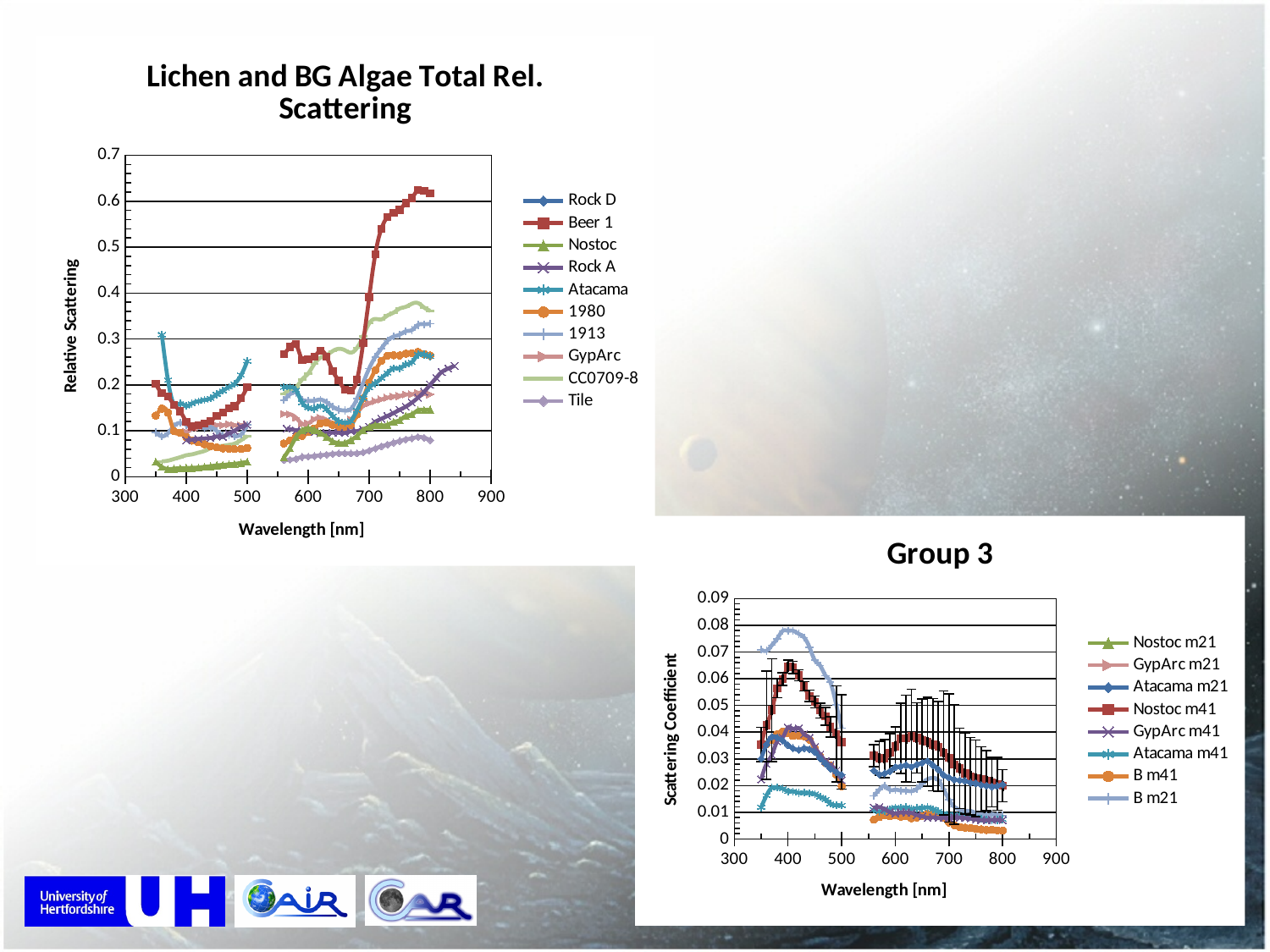
In the 'Lichen and BG Algae Total Rel. Scattering' chart, is the value for Tile at 600 nm greater or less than 0.1? less What kind of chart is the 'Lichen and BG Algae Total Rel. Scattering' chart? line chart What is the y-axis title of the 'Lichen and BG Algae Total Rel. Scattering' chart? Relative Scattering In the 'Group 3' chart, is the value for B m21 at 400 nm greater or less than 0.07? greater In the 'Group 3' chart, is the value for Atacama m41 at 400 nm greater or less than 0.03? less In the 'Lichen and BG Algae Total Rel. Scattering' chart, does the Beer 1 series rise or fall between 700 nm and 800 nm? rise In the 'Lichen and BG Algae Total Rel. Scattering' chart, which series reaches the highest relative scattering value? Beer 1 In the 'Group 3' chart, which series reaches the highest scattering coefficient? B m21 What is the x-axis title of the 'Group 3' chart? Wavelength [nm] How many series does the legend of the 'Group 3' chart list? 8 How many series does the legend of the 'Lichen and BG Algae Total Rel. Scattering' chart list? 10